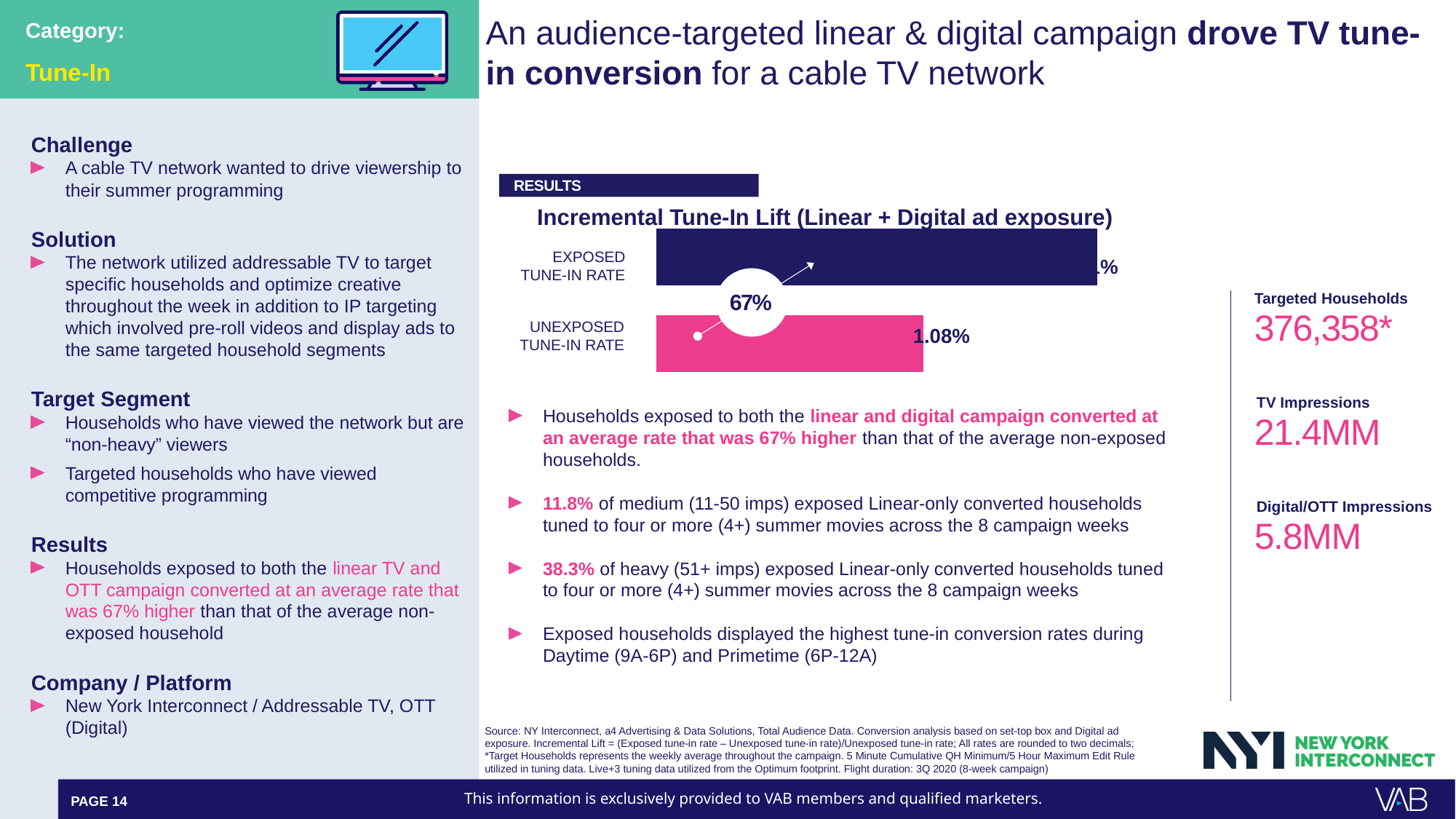
How many bars are plotted in the Incremental Tune-In Lift chart? 2 What is the unexposed tune-in rate shown in the chart? 1.08% What are the two categories labelled on the chart's vertical axis? Exposed tune-in rate and unexposed tune-in rate What percentage lift is shown in the circle callout between the two bars? 67% Which category has the higher tune-in rate in the chart? Exposed tune-in rate What kind of chart is shown under the RESULTS heading? Bar chart What is the title of the chart? Incremental Tune-In Lift (Linear + Digital ad exposure) Is the exposed tune-in rate bar longer or shorter than the unexposed tune-in rate bar? Longer Which category has the lower tune-in rate in the chart? Unexposed tune-in rate